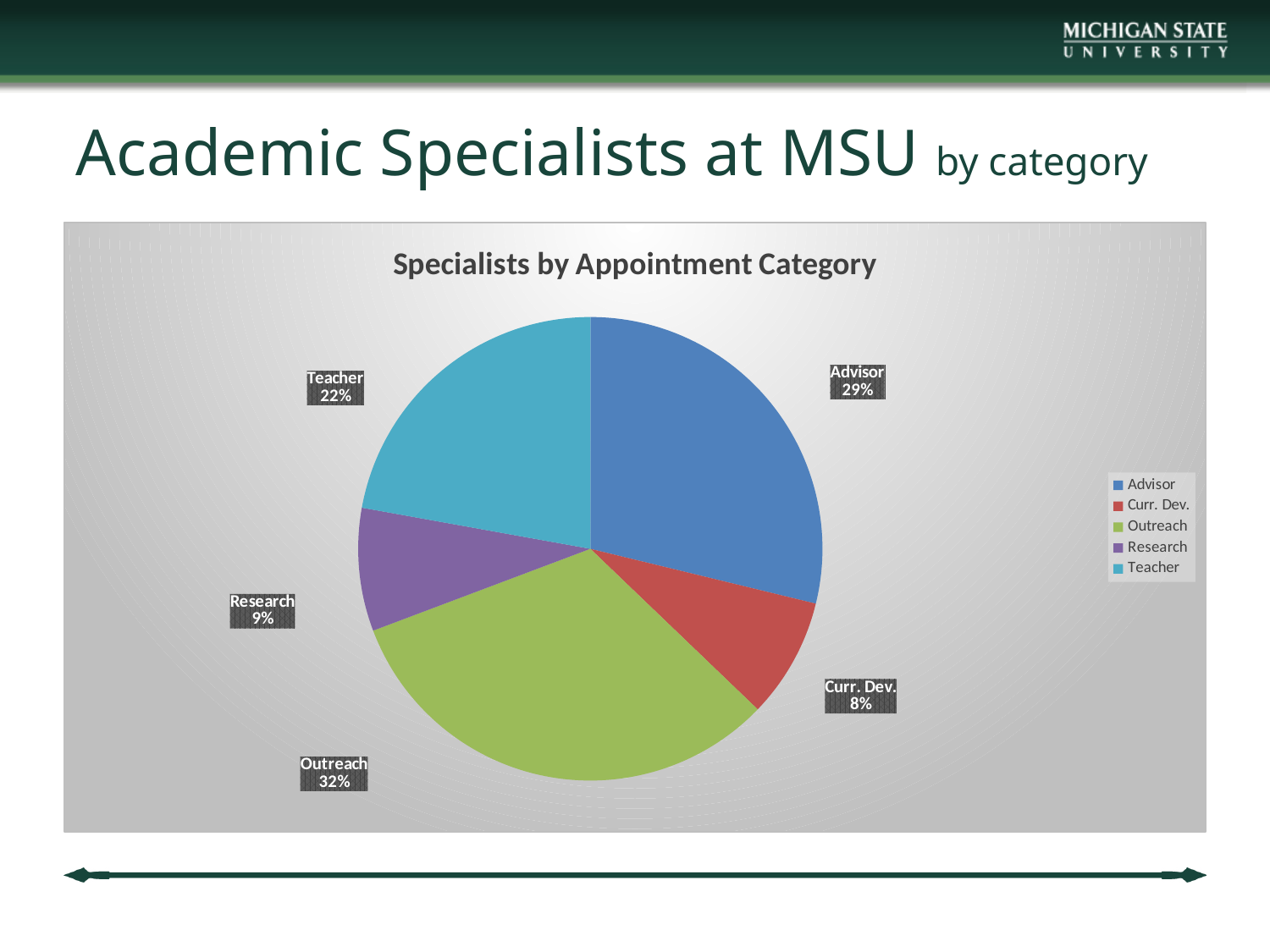
What share of the pie does Outreach represent? 32% What is the value shown for Advisor? 29% Which category has the largest slice of the pie? Outreach How many categories are shown in the pie chart? 5 What is the difference in percentage points between Outreach and Teacher? 10 What colour is the Outreach slice? Green What is the value shown for Research? 9% What is the value shown for Curr. Dev.? 8% Which category has the smallest slice of the pie? Curr. Dev. Which is larger, the Advisor slice or the Teacher slice? Advisor What is the title of the chart? Specialists by Appointment Category What kind of chart is shown on the slide? Pie chart